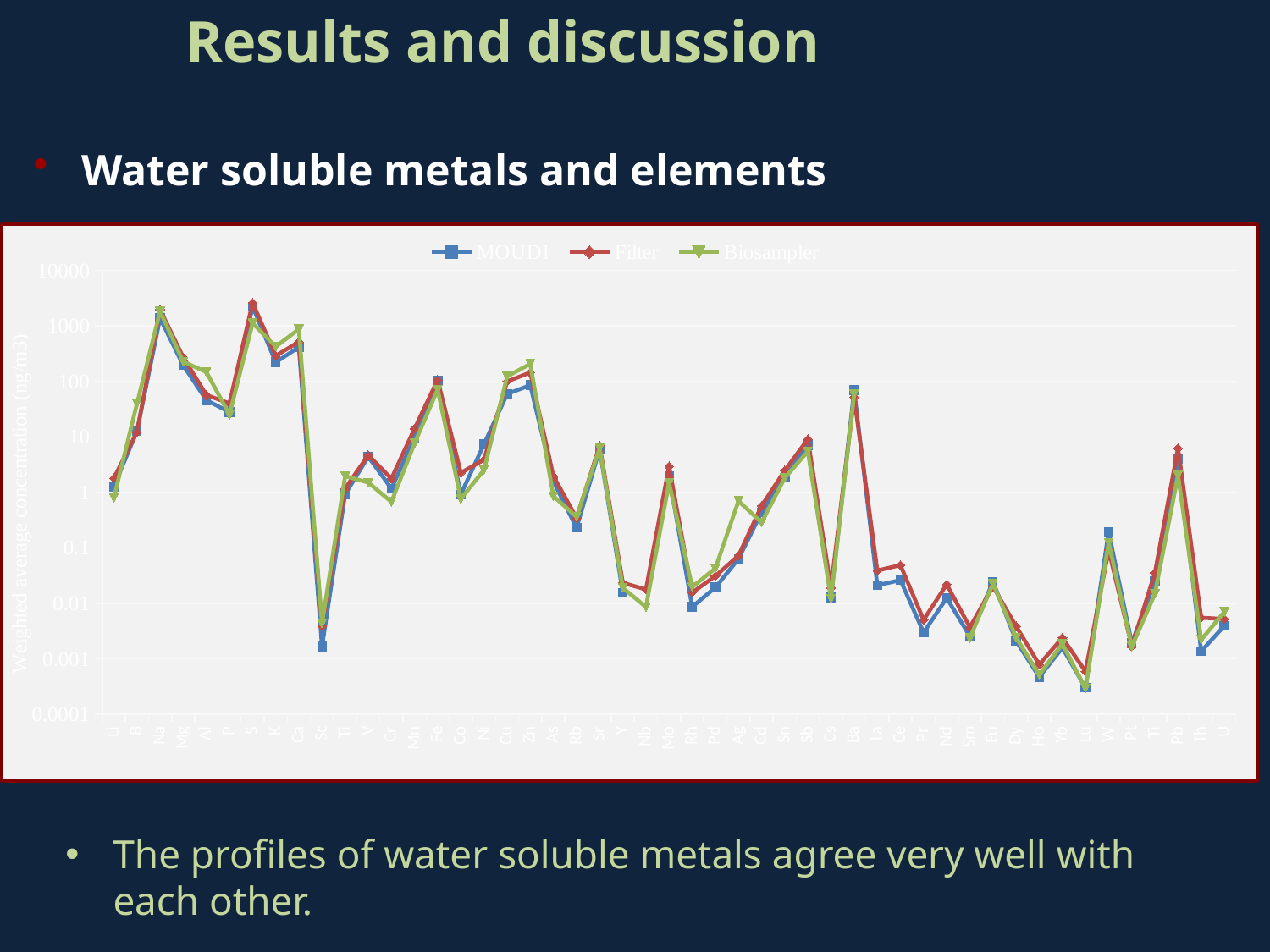
Which element has the lowest concentration across all three series? Lu Is the value for Sc in the Filter series greater or less than 0.01? less Is the value for Na in the MOUDI series greater or less than 1000? greater Is the value for Ho in the MOUDI series greater or less than 0.001? less What are the three series named in the chart legend? MOUDI, Filter, Biosampler What is the label of the y axis of the chart? Weighed average concentration (ng/m3) How many series does the chart legend list? 3 Which is larger in the Filter series, the value for Na or the value for Sc? Na What kind of chart is shown on the slide? line chart